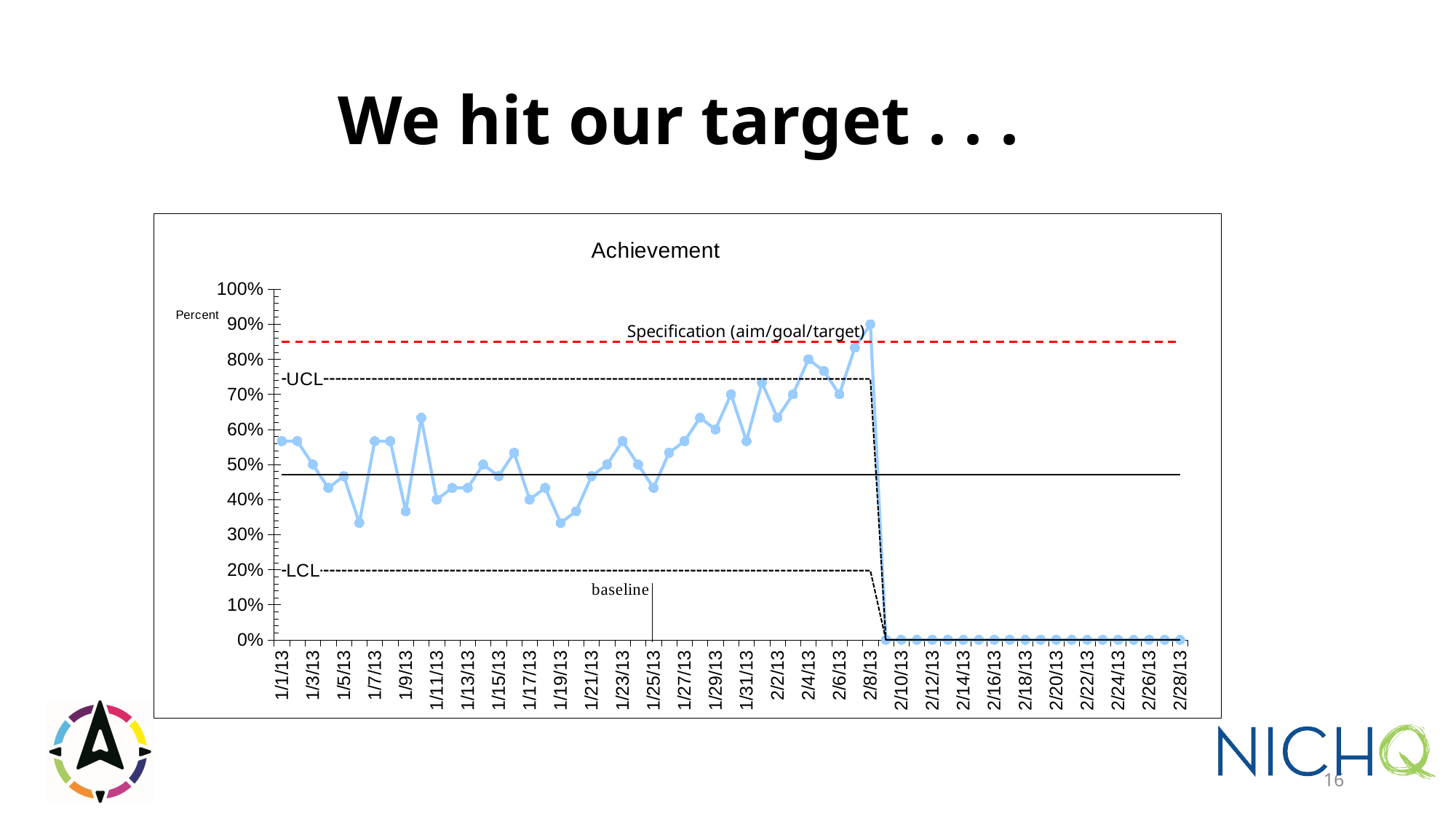
On which date does the Achievement line reach its highest value? 2/8/13 Is the value for 2/8/13 greater or less than 80%? greater Is the value for 1/1/13 greater or less than 50%? greater Which is larger, the value for 2/8/13 or the value for 1/1/13? 2/8/13 What does the red dashed horizontal line represent, according to its label? Specification (aim/goal/target) Is the value for 2/4/13 greater or less than 70%? greater What is the value for 2/10/13? 0% What kind of chart is shown on the slide? line chart What is the value for 2/28/13? 0% What is the title of the chart? Achievement Between 1/21/13 and 2/8/13, do the values generally rise or fall? rise